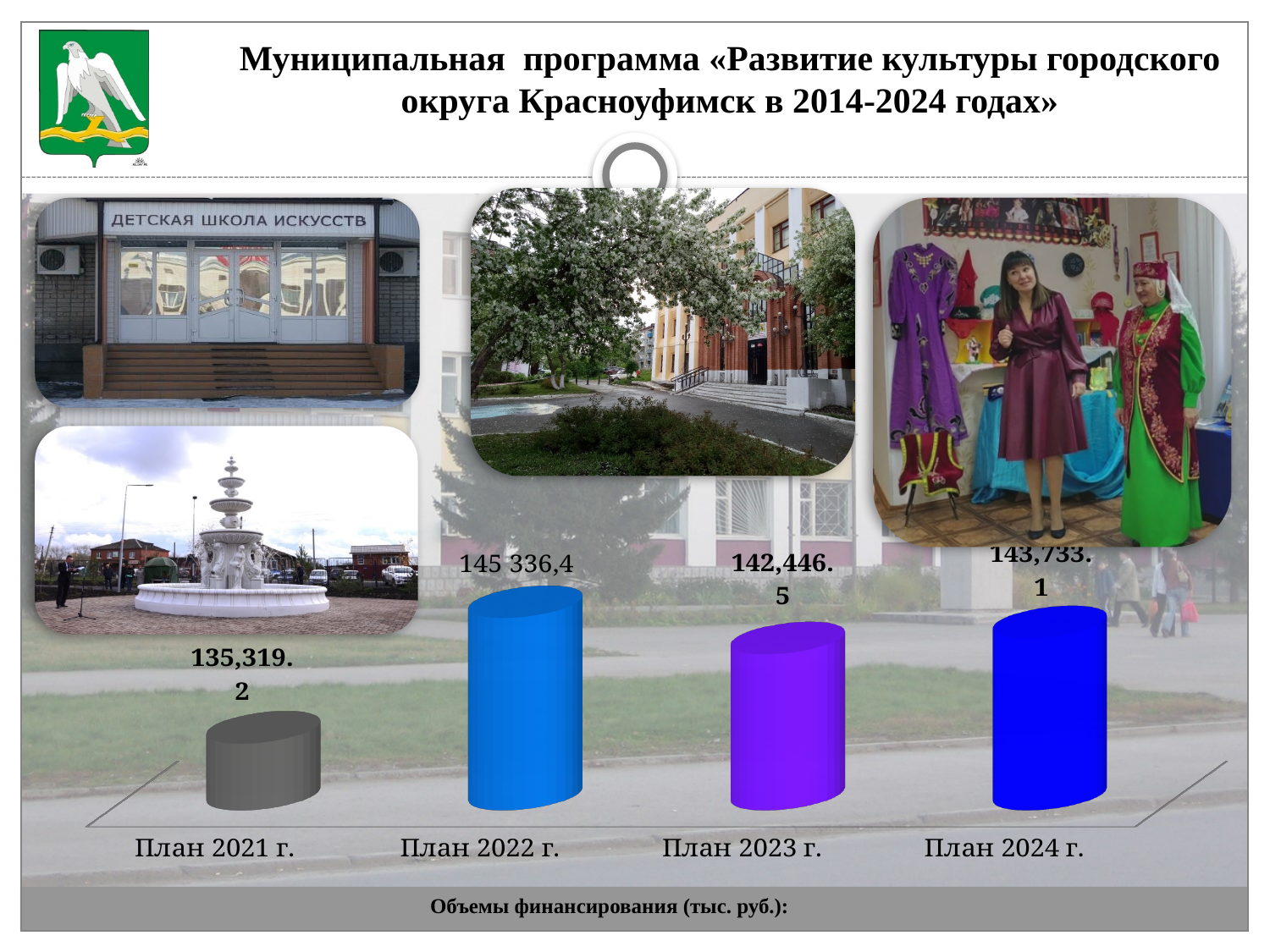
What kind of chart is shown on the slide? Bar chart Which category has the lowest value? План 2021 г. How many categories are shown in the chart? 4 Which category has the highest value? План 2022 г. What is the value for План 2021 г.? 135,319.2 What unit is given in the caption below the chart? тыс. руб. Does the value rise or fall from План 2021 г. to План 2022 г.? Rise What is the value for План 2023 г.? 142,446.5 What is the value for План 2024 г.? 143,733.1 What is the difference between the values for План 2024 г. and План 2023 г.? 1,286.6 What is the value for План 2022 г.? 145 336,4 Which is larger, the value for План 2023 г. or План 2024 г.? План 2024 г.